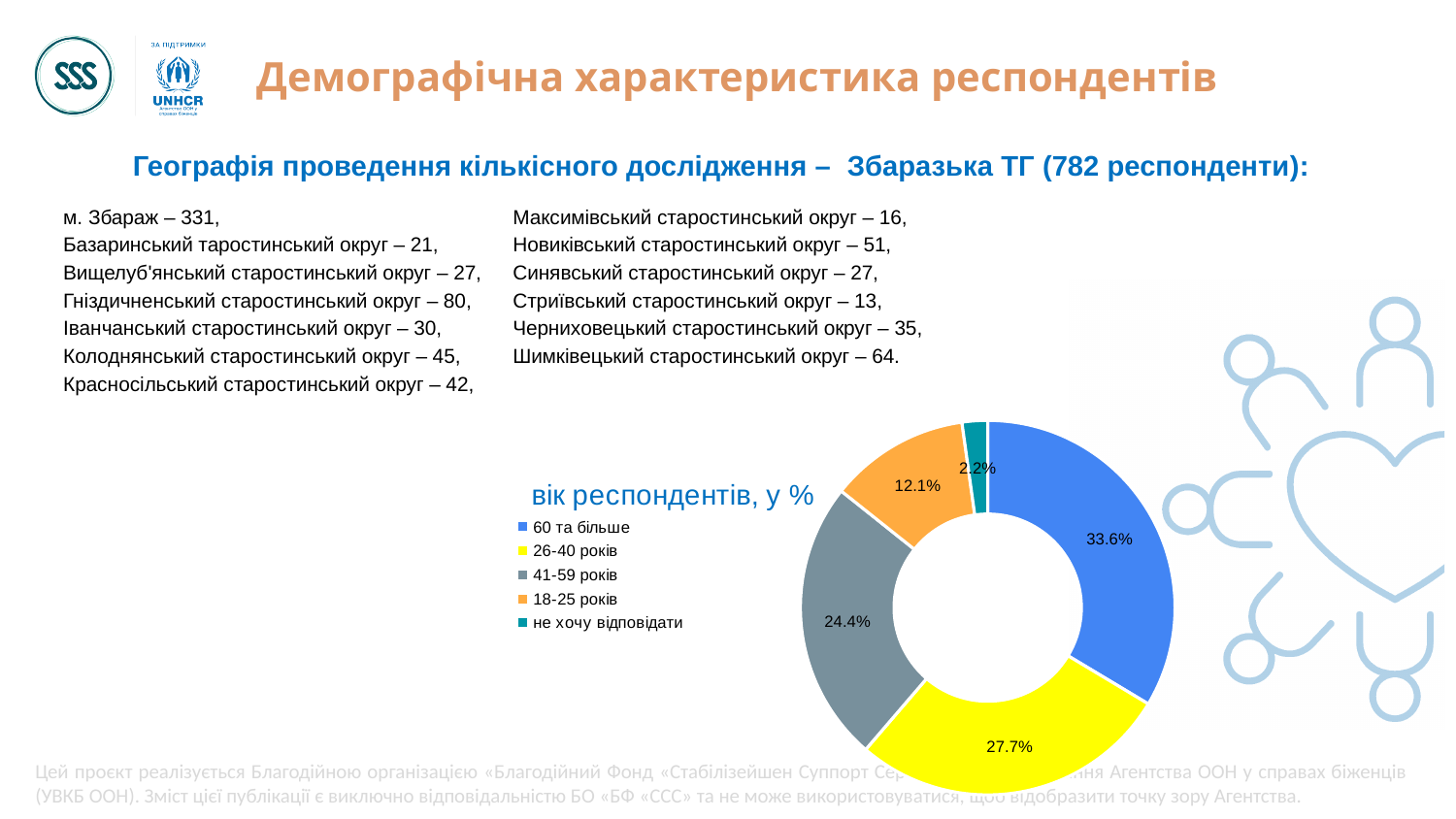
What is the difference in percentage points between the 60 та більше group and the 18-25 років group? 21.5 What share of respondents are aged 26-40 років? 27.7% What is the title of the chart? вік респондентів, у % What share of respondents are aged 60 and over (60 та більше)? 33.6% Which category has the smallest share of respondents? не хочу відповідати What share of respondents chose 'не хочу відповідати'? 2.2% How many categories does the age chart show? 5 Which age group has the largest share of respondents? 60 та більше Which group has a larger share: 26-40 років or 41-59 років? 26-40 років What share of respondents are aged 18-25 років? 12.1% What type of chart is used to show the age of respondents? Doughnut chart What share of respondents are aged 41-59 років? 24.4%